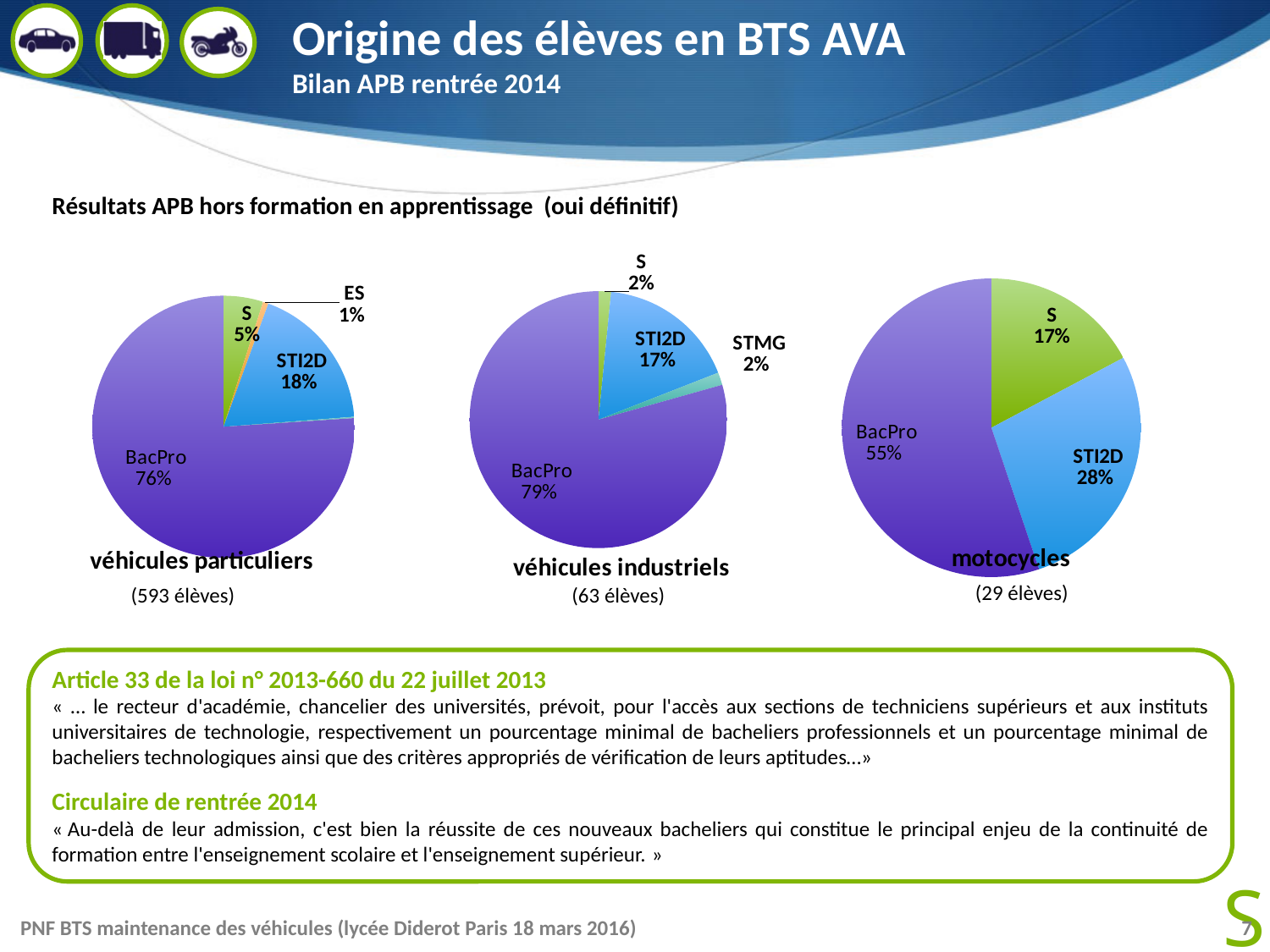
In the 'motocycles' pie chart, which category has the largest share? BacPro How many categories are shown in the 'véhicules industriels' pie chart? 4 How many categories are shown in the 'motocycles' pie chart? 3 In the 'véhicules particuliers' pie chart, what share do BacPro students represent? 76% In the 'véhicules particuliers' pie chart, which category has the smallest share? ES In the 'véhicules industriels' pie chart, which is larger, the share for STI2D or the share for STMG? STI2D In the 'véhicules particuliers' pie chart, what is the share for ES? 1% In the 'motocycles' pie chart, what is the share for S? 17% In the 'motocycles' pie chart, what is the difference between the BacPro share and the STI2D share? 27 percentage points How many students does the 'véhicules industriels' pie chart cover, according to the label under it? 63 élèves In the 'véhicules industriels' pie chart, what share do STI2D students represent? 17% What type of chart is used for 'véhicules particuliers'? Pie chart